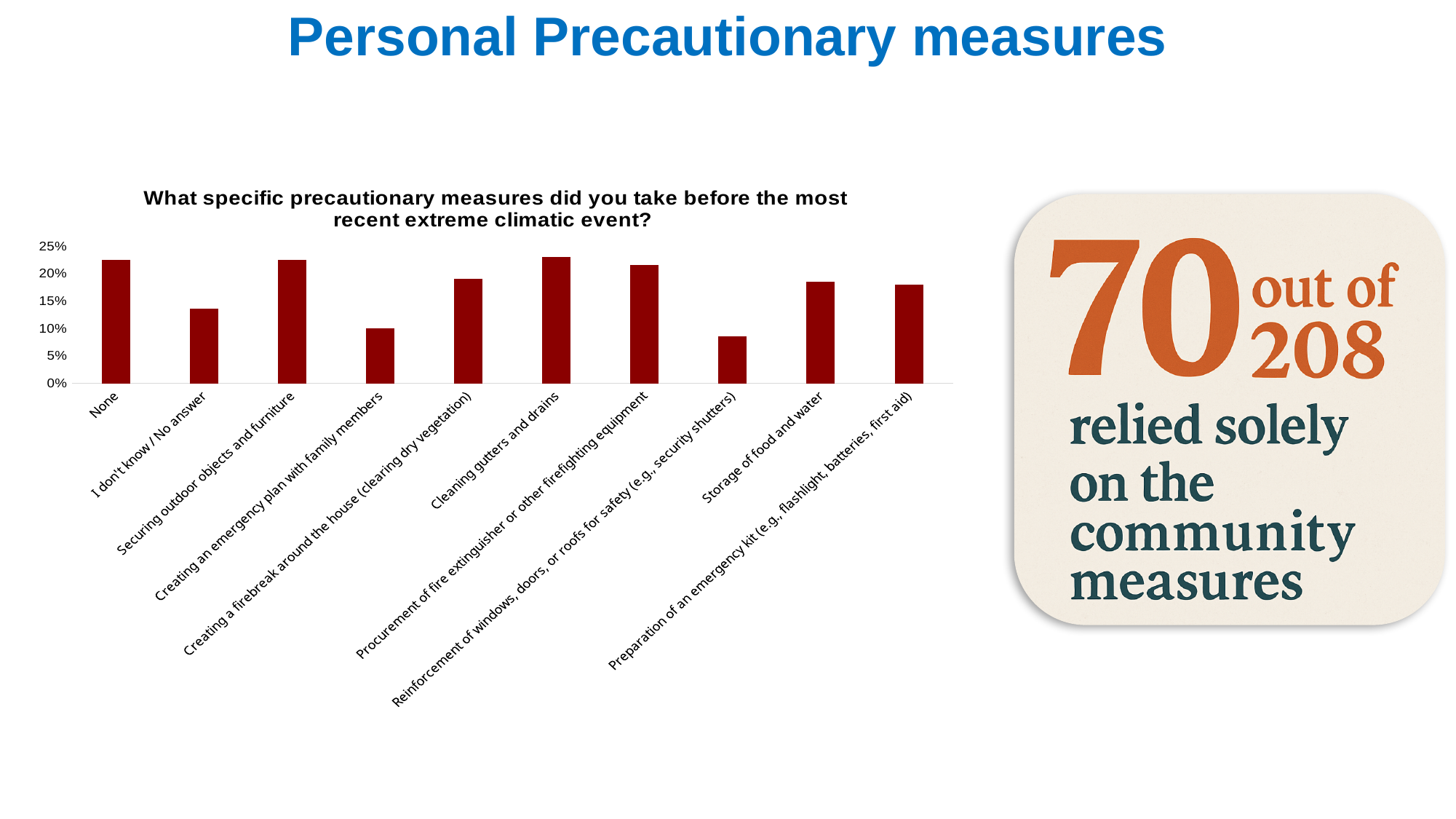
What kind of chart is shown on the slide? bar chart Is the value for "Preparation of an emergency kit" greater or less than 20%? less Which is larger: the value for "None" or the value for "I don't know / No answer"? None Is the value for "None" greater or less than 20%? greater Is the value for "I don't know / No answer" greater or less than 15%? less How many categories (precautionary measures) are shown on the x axis of the chart? 10 Which category has the lowest value in the chart? Reinforcement of windows, doors, or roofs for safety (e.g., security shutters) What is the title of the chart? What specific precautionary measures did you take before the most recent extreme climatic event? Which is larger: the value for "Cleaning gutters and drains" or the value for "Creating an emergency plan with family members"? Cleaning gutters and drains